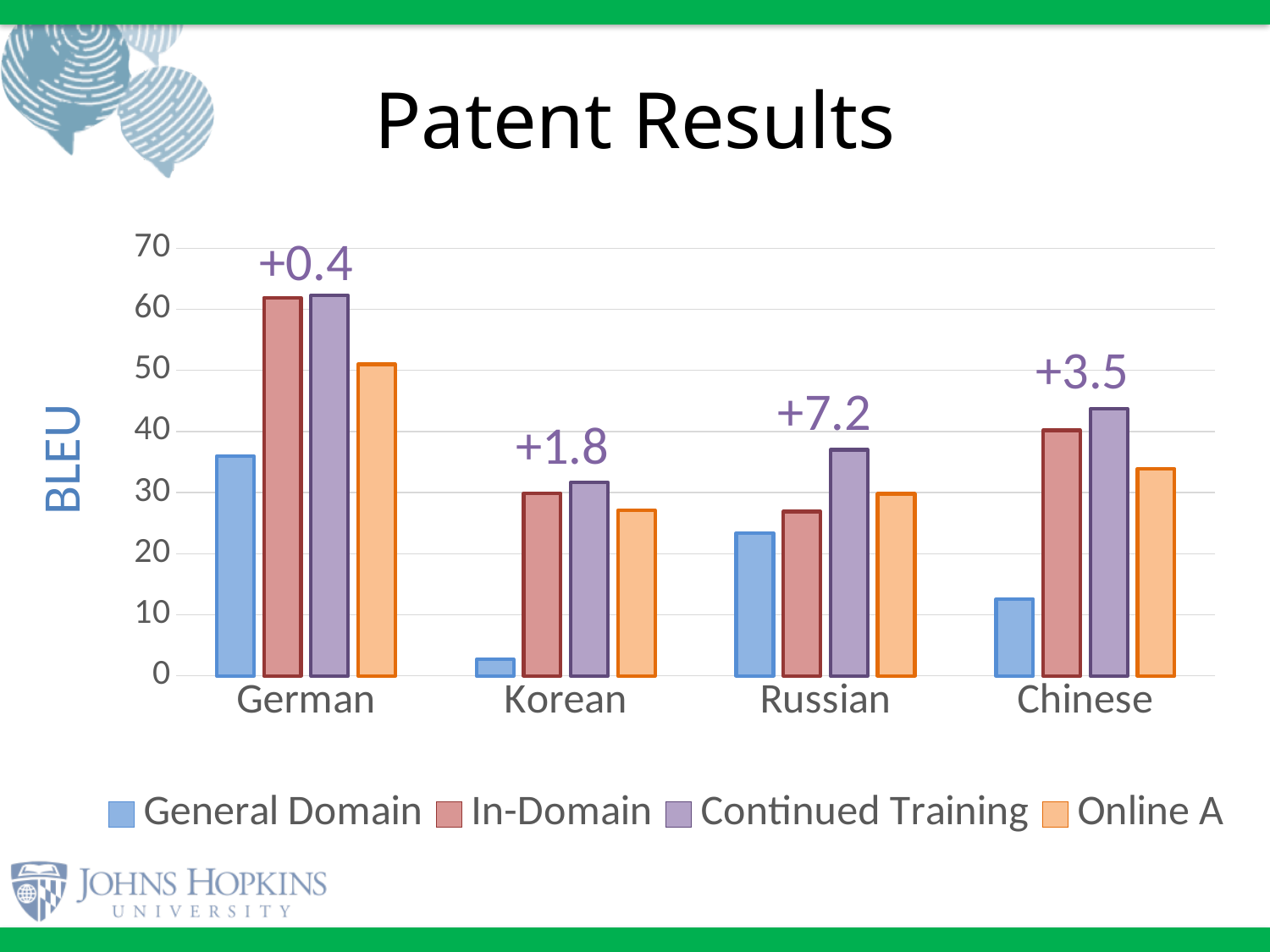
Which language has the highest Continued Training bar? German Which language has the smallest annotated improvement? German For Russian, which is larger: Continued Training or Online A? Continued Training What kind of chart is shown on the slide? bar chart Is the Continued Training value for Russian greater or less than 30? greater How many languages are shown on the x axis? 4 Is the General Domain value for Korean greater or less than 10? less What is the title of the chart? Patent Results Which language has the largest annotated improvement? Russian How many series does the legend list? 4 What improvement value is annotated above the Russian group? +7.2 What improvement value is annotated above the German group? +0.4